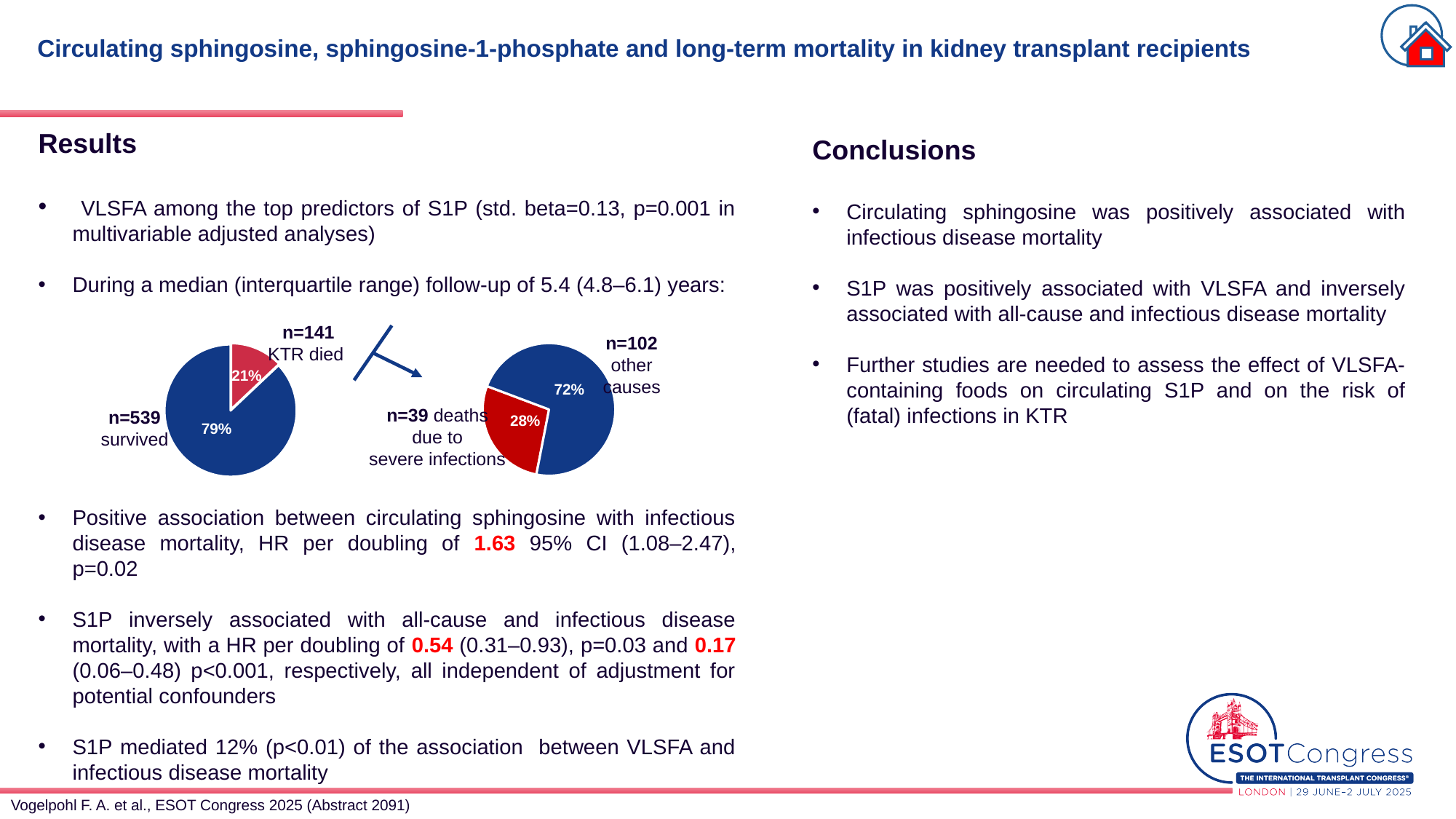
On the left pie chart, what percentage of KTR died? 21% On the right pie chart, how many deaths were due to other causes? n=102 On the right pie chart, what percentage of deaths were due to severe infections? 28% On the right pie chart, how many deaths were due to severe infections? n=39 On the right pie chart, which slice is the smallest? deaths due to severe infections On the left pie chart, which slice is larger: survived or KTR died? survived On the left pie chart, how many KTR died? n=141 On the right pie chart, what percentage of deaths were due to other causes? 72% On the left pie chart, how many KTR survived? n=539 How many slices does the right pie chart have? 2 On the left pie chart, what percentage of KTR survived? 79% What type of chart is used to show the survival and death proportions on the slide? pie chart